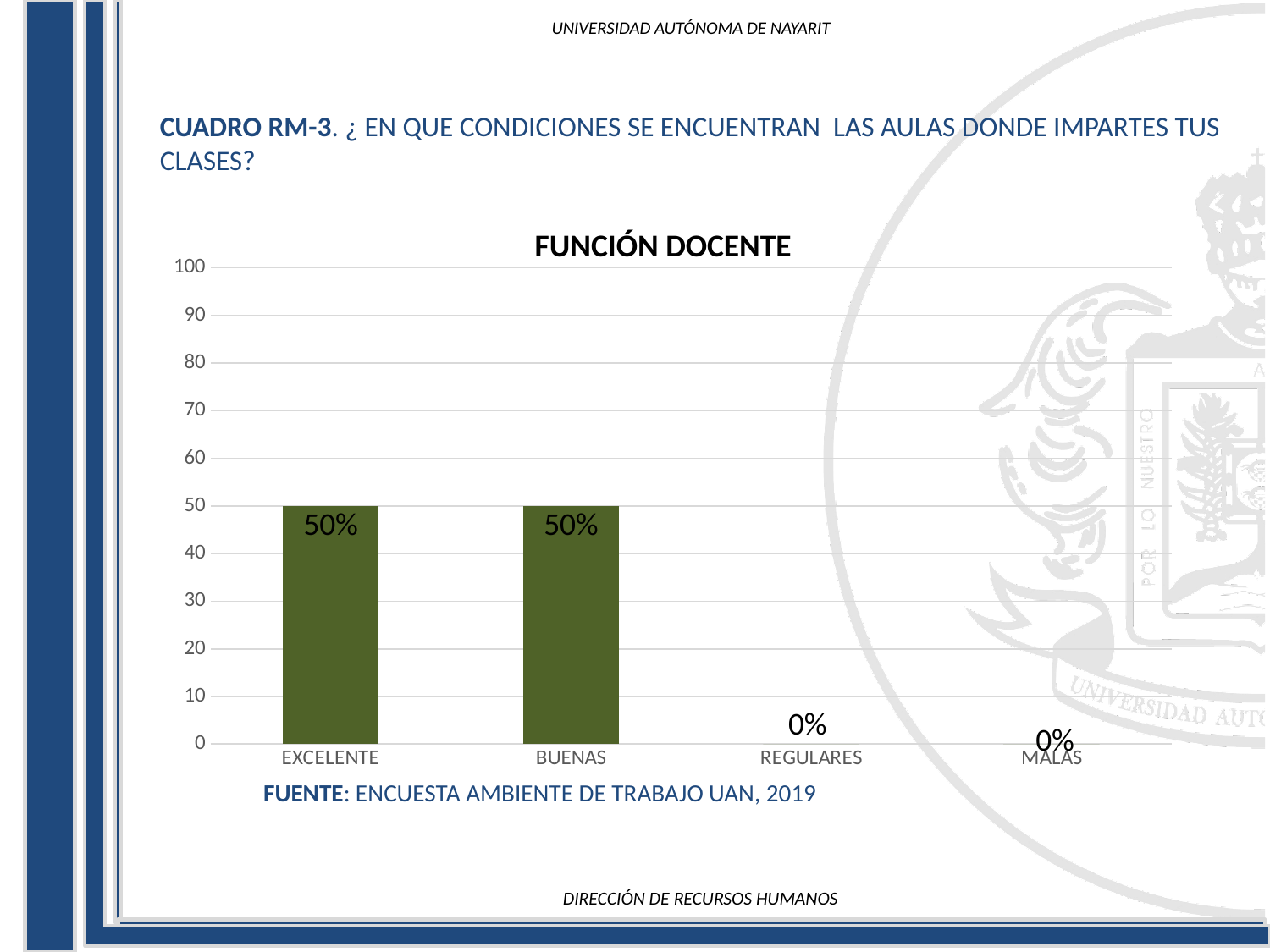
What is the value for MALAS? 0% What is the difference between the values for EXCELENTE and REGULARES? 50% What kind of chart is shown on the slide? bar chart What is the highest value shown on the vertical axis? 100 What is the value for EXCELENTE? 50% What is the title of the chart? FUNCIÓN DOCENTE Do the values rise or fall from EXCELENTE to MALAS along the x axis? fall Which is larger, the value for BUENAS or the value for MALAS? BUENAS What is the value for REGULARES? 0% How many categories are shown on the x axis? 4 Is the value for EXCELENTE greater or less than 40? greater What is the value for BUENAS? 50%